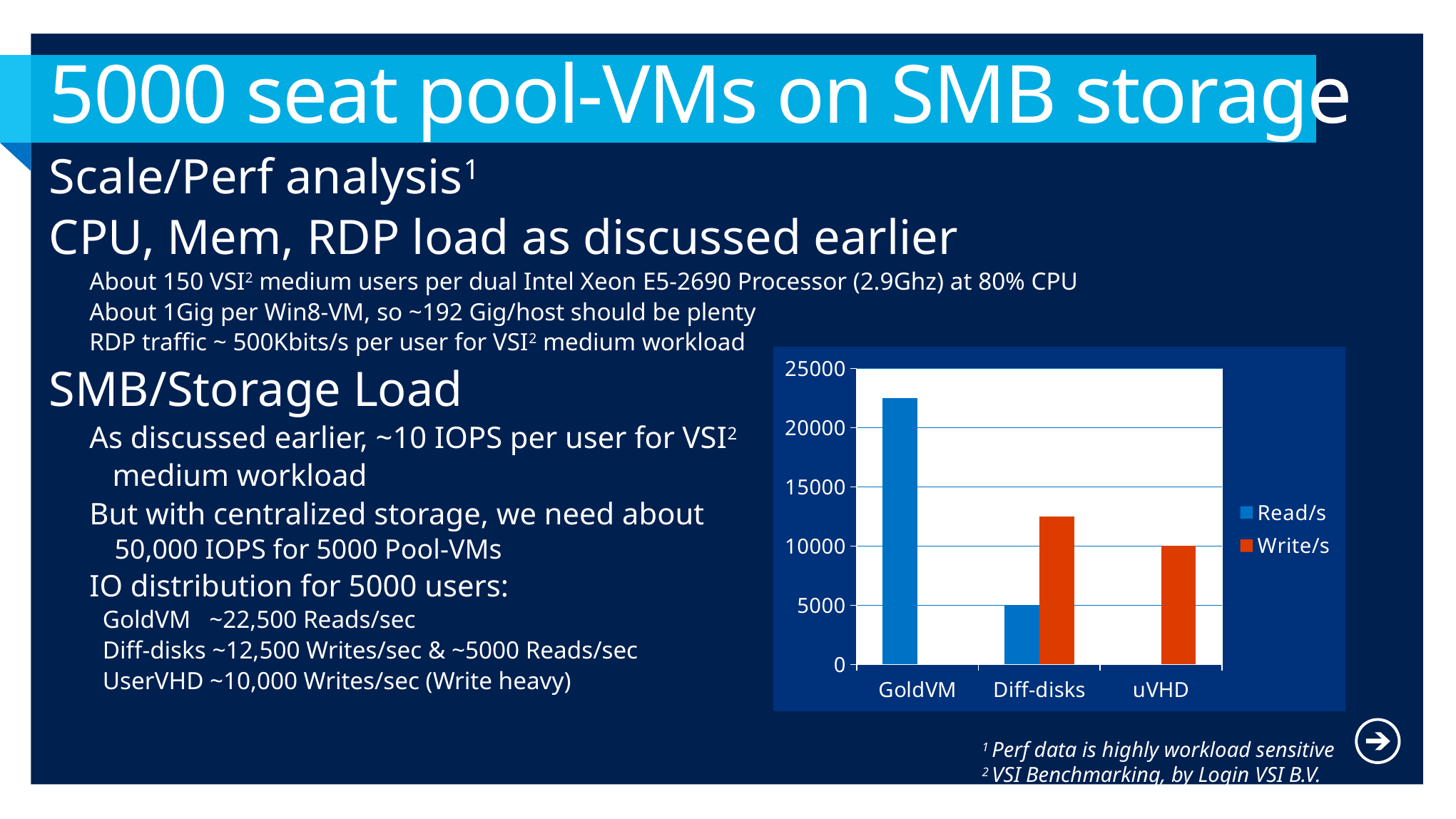
What colour are the Write/s bars in the chart? orange-red For Diff-disks, which is larger, Read/s or Write/s? Write/s What is the Write/s value for uVHD in the chart? 10000 How many series does the chart legend list? 2 Which category has the tallest Write/s bar in the chart? Diff-disks What kind of chart is shown on the slide? bar chart How many categories are shown on the x axis of the chart? 3 Is the Read/s value for GoldVM greater or less than 20000? greater Is the Write/s value for Diff-disks greater or less than 15000? less Which is larger, the Read/s value for GoldVM or the Write/s value for uVHD? Read/s value for GoldVM What is the Read/s value for Diff-disks in the chart? 5000 Which category has the tallest Read/s bar in the chart? GoldVM